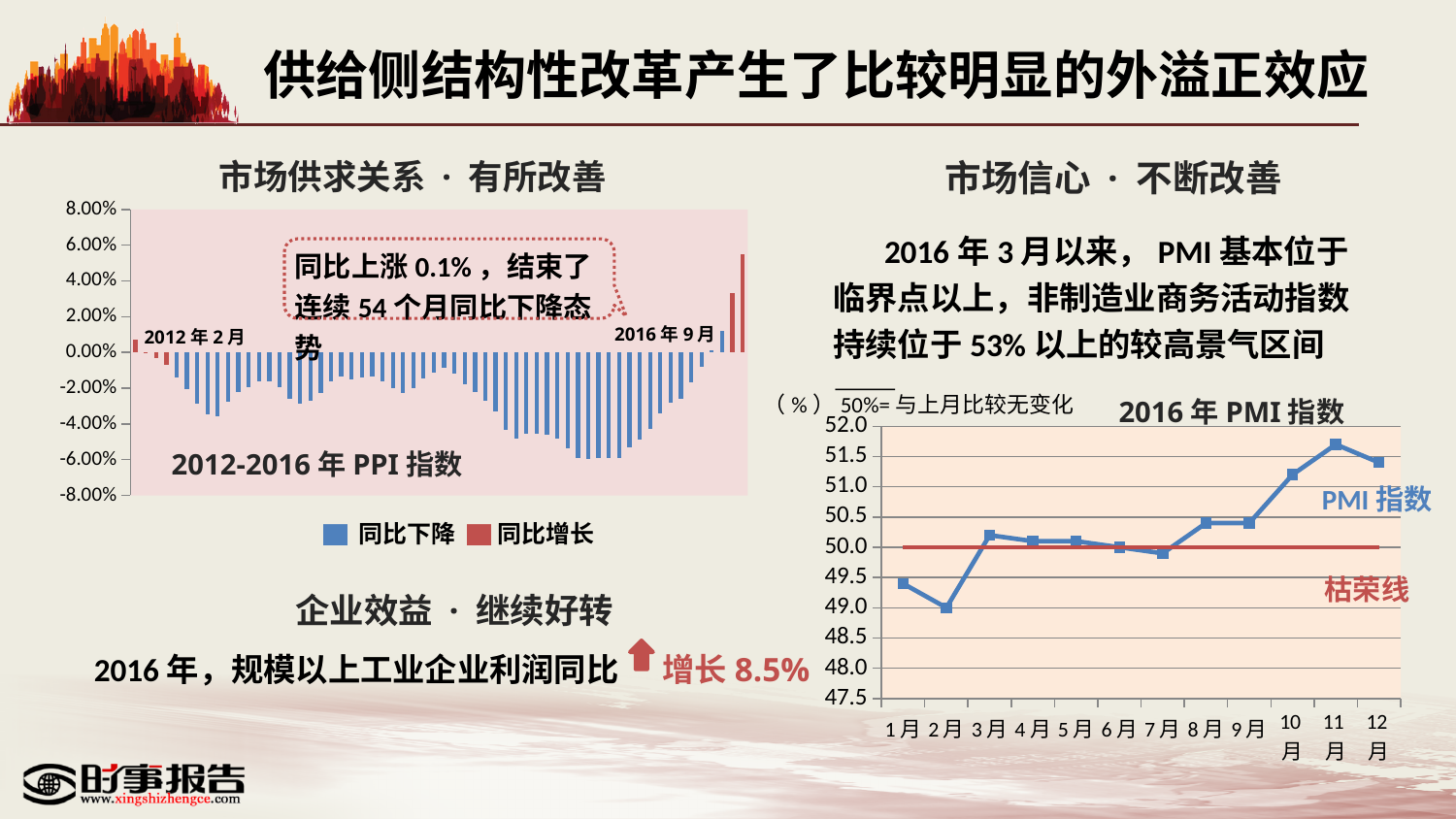
In the 2016年PMI指数 chart, is the PMI value for 2月 greater or less than 49.5? less In the 2016年PMI指数 chart, which month has the lowest PMI value? 2月 In the 2016年PMI指数 chart, does the PMI line rise or fall from 9月 to 11月? rise What kind of chart is the 2012-2016年PPI指数 chart on the left? bar chart In the 2016年PMI指数 chart, which month has a higher PMI value, 11月 or 12月? 11月 In the 2012-2016年PPI指数 chart, how many series does the legend list? 2 What kind of chart is the 2016年PMI指数 chart on the right? line chart In the 2016年PMI指数 chart, how many months are plotted on the x axis? 12 In the 2012-2016年PPI指数 chart, which colour represents 同比增长? red In the 2016年PMI指数 chart, which month has the highest PMI value? 11月 In the 2016年PMI指数 chart, is the PMI value for 11月 greater or less than 51.5? greater In the 2016年PMI指数 chart, at what level is the red horizontal 枯荣线 drawn? 50.0